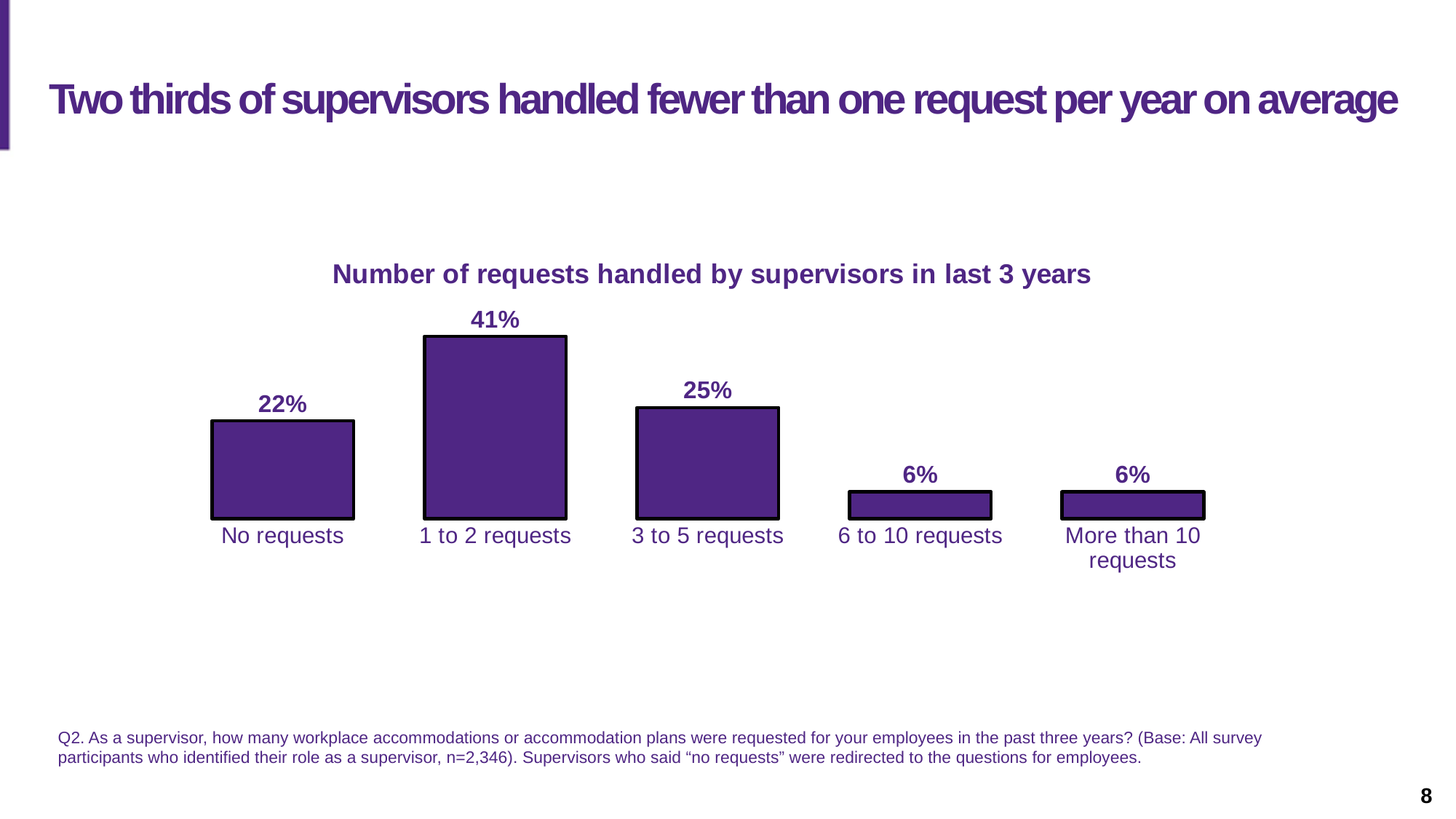
What percentage of supervisors handled 3 to 5 requests? 25% What kind of chart is shown on the slide? Bar chart What is the difference between the percentages for No requests and 6 to 10 requests? 16% Which is larger, the percentage for No requests or for 3 to 5 requests? 3 to 5 requests What is the difference between the percentages for 1 to 2 requests and 3 to 5 requests? 16% What percentage of supervisors handled 6 to 10 requests? 6% How many categories are shown in the chart? 5 What percentage of supervisors handled no requests? 22% Which category has the highest percentage? 1 to 2 requests What percentage of supervisors handled 1 to 2 requests? 41% What is the combined percentage for 6 to 10 requests and More than 10 requests? 12% What is the title of the chart? Number of requests handled by supervisors in last 3 years